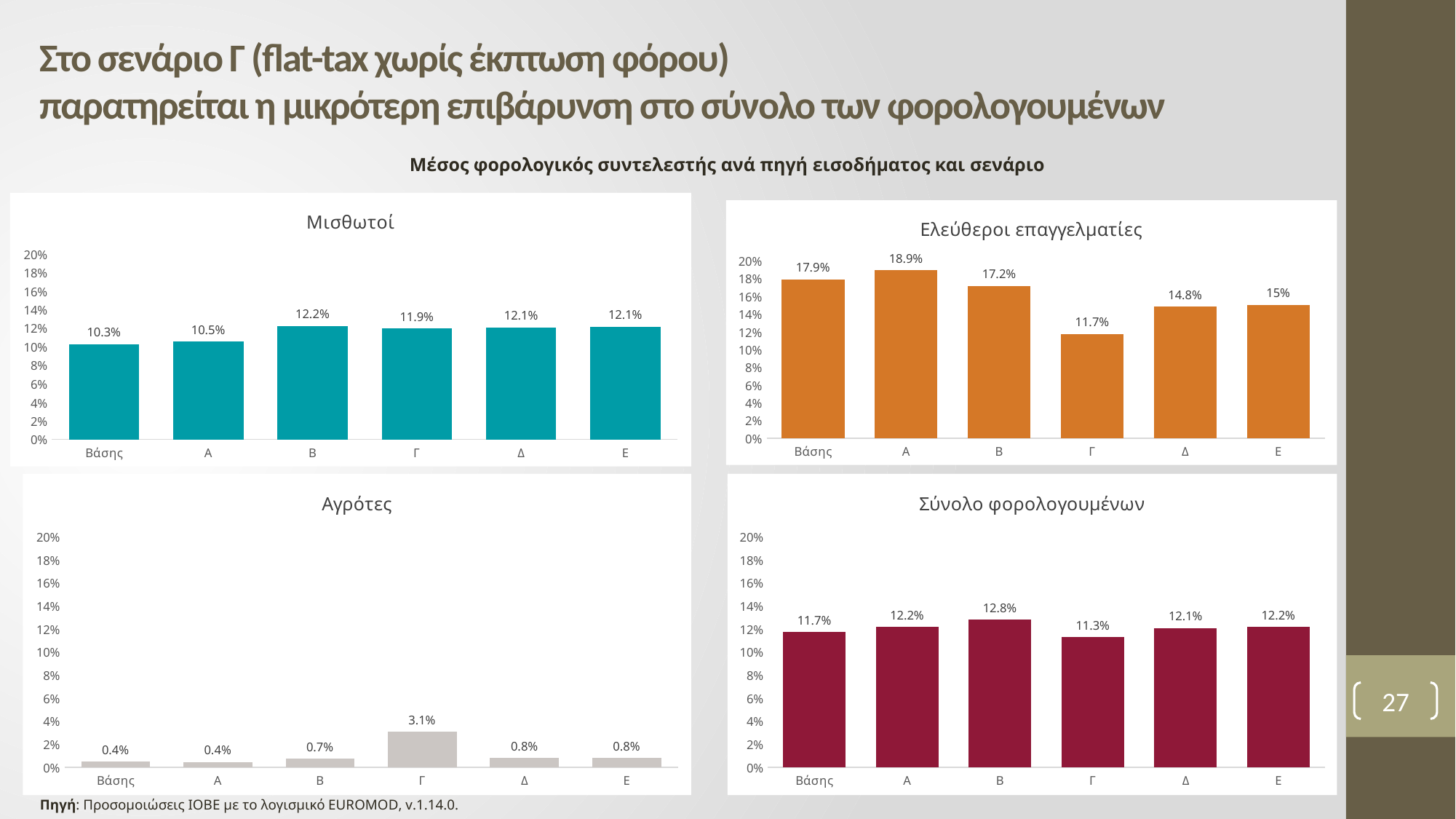
How many charts are shown on the slide? 4 In the 'Σύνολο φορολογουμένων' chart, what is the difference between the values for Β and Γ? 1.5% In the 'Σύνολο φορολογουμένων' chart, which is larger, the value for Βάσης or the value for Α? Α In the 'Ελεύθεροι επαγγελματίες' chart, which category has the highest value? Α What kind of chart is the 'Μισθωτοί' chart? bar chart How many categories are shown on the x axis of the 'Αγρότες' chart? 6 In the 'Ελεύθεροι επαγγελματίες' chart, what is the difference between the values for Α and Γ? 7.2% In the 'Μισθωτοί' chart, what is the value for Βάσης? 10.3% In the 'Μισθωτοί' chart, which category has the highest value? Β In the 'Ελεύθεροι επαγγελματίες' chart, is the value for Γ greater or less than 14%? less In the 'Ελεύθεροι επαγγελματίες' chart, which category has the lowest value? Γ In the 'Αγρότες' chart, what is the value for Γ? 3.1%